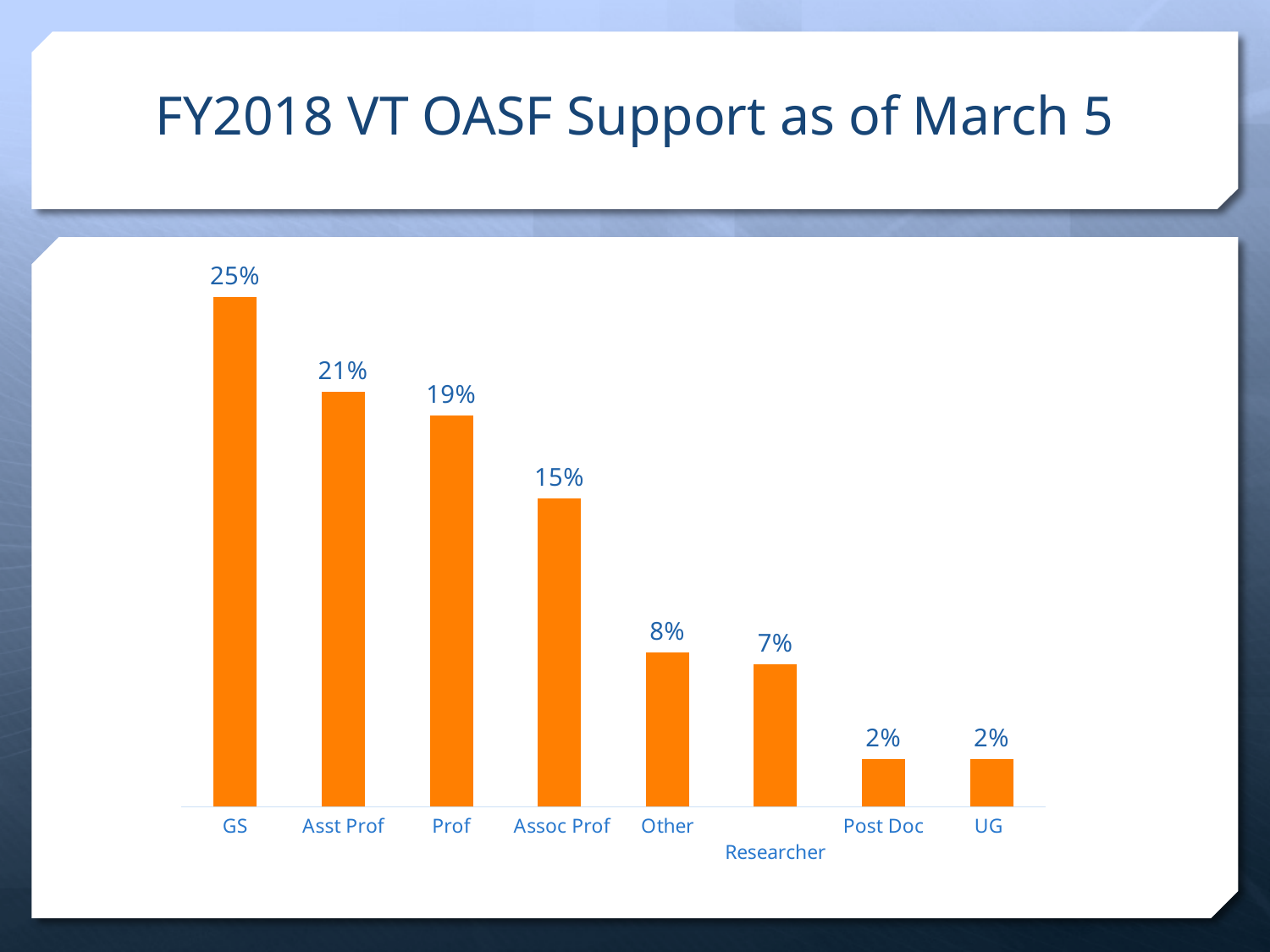
Which is larger, the value for Asst Prof or the value for Prof? Asst Prof What is the value for Researcher? 7% Which category has the highest value? GS What is the value for Assoc Prof? 15% What is the difference between the values for GS and Asst Prof? 4% What is the value for GS? 25% Do the values rise or fall from left to right along the x axis? Fall What is the title of the chart? FY2018 VT OASF Support as of March 5 What is the difference between the values for Prof and Other? 11% Which is larger, the value for Other or the value for Researcher? Other How many categories are shown on the chart? 8 What kind of chart is shown on the slide? Bar chart